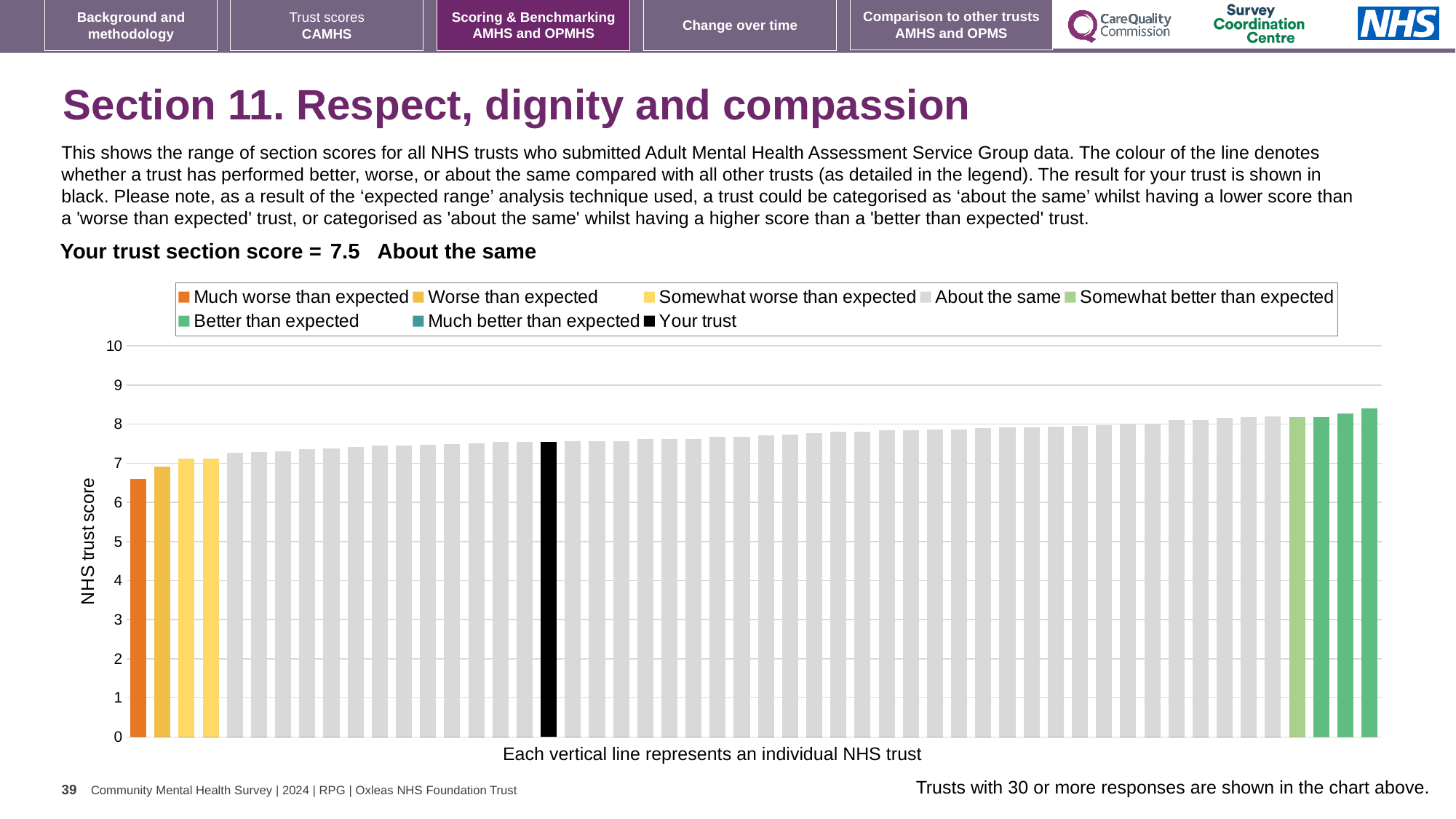
What is the label on the vertical axis of the chart? NHS trust score How many bars are coloured in the 'Better than expected' green? 3 Is the value of the black 'Your trust' bar greater or less than 7? greater How many entries does the chart legend list? 8 What does the caption below the x axis say each vertical line represents? An individual NHS trust Do the bar values rise or fall from left to right along the x axis? rise Which is larger: the value of the black 'Your trust' bar or the orange 'Much worse than expected' bar? Your trust Is the value of the orange 'Much worse than expected' bar greater or less than 7? less What kind of chart is shown on the slide? Bar chart Is the value of the tallest bar on the right greater or less than 8? greater What is the section score for your trust (the black bar)? 7.5 How many bars are coloured orange for 'Much worse than expected'? 1